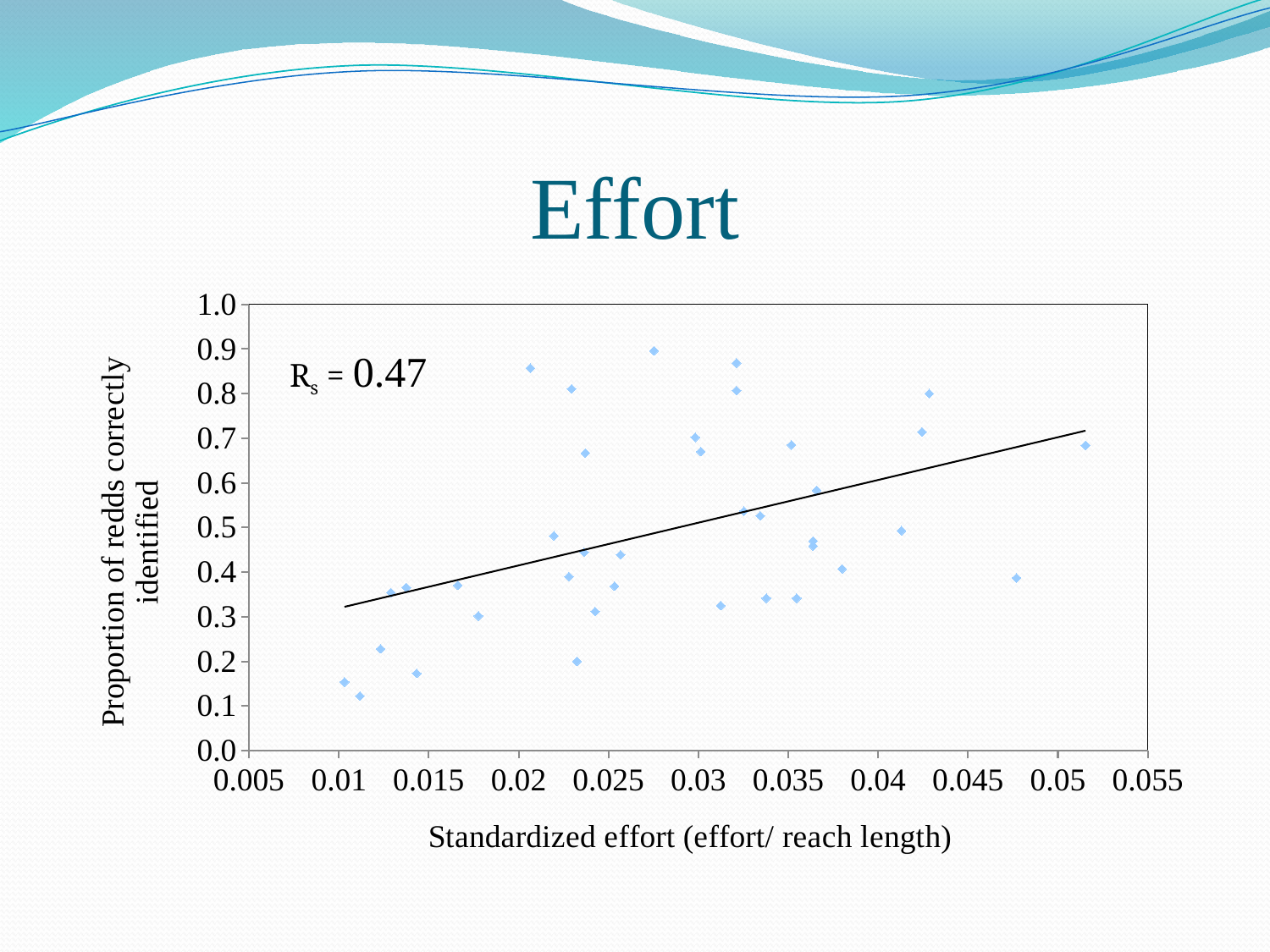
What kind of chart is shown on the slide? scatter chart Is the value of the fitted line at a standardized effort of 0.05 greater or less than 0.6? greater What value of Rs is printed on the chart? 0.47 Is the value of the fitted line at a standardized effort of 0.01 greater or less than 0.4? less Is the proportion for the highest point on the chart greater or less than 0.8? greater What is the title of the chart? Effort Does the fitted line rise or fall as standardized effort increases along the x axis? rises What is the label of the x axis? Standardized effort (effort/ reach length)